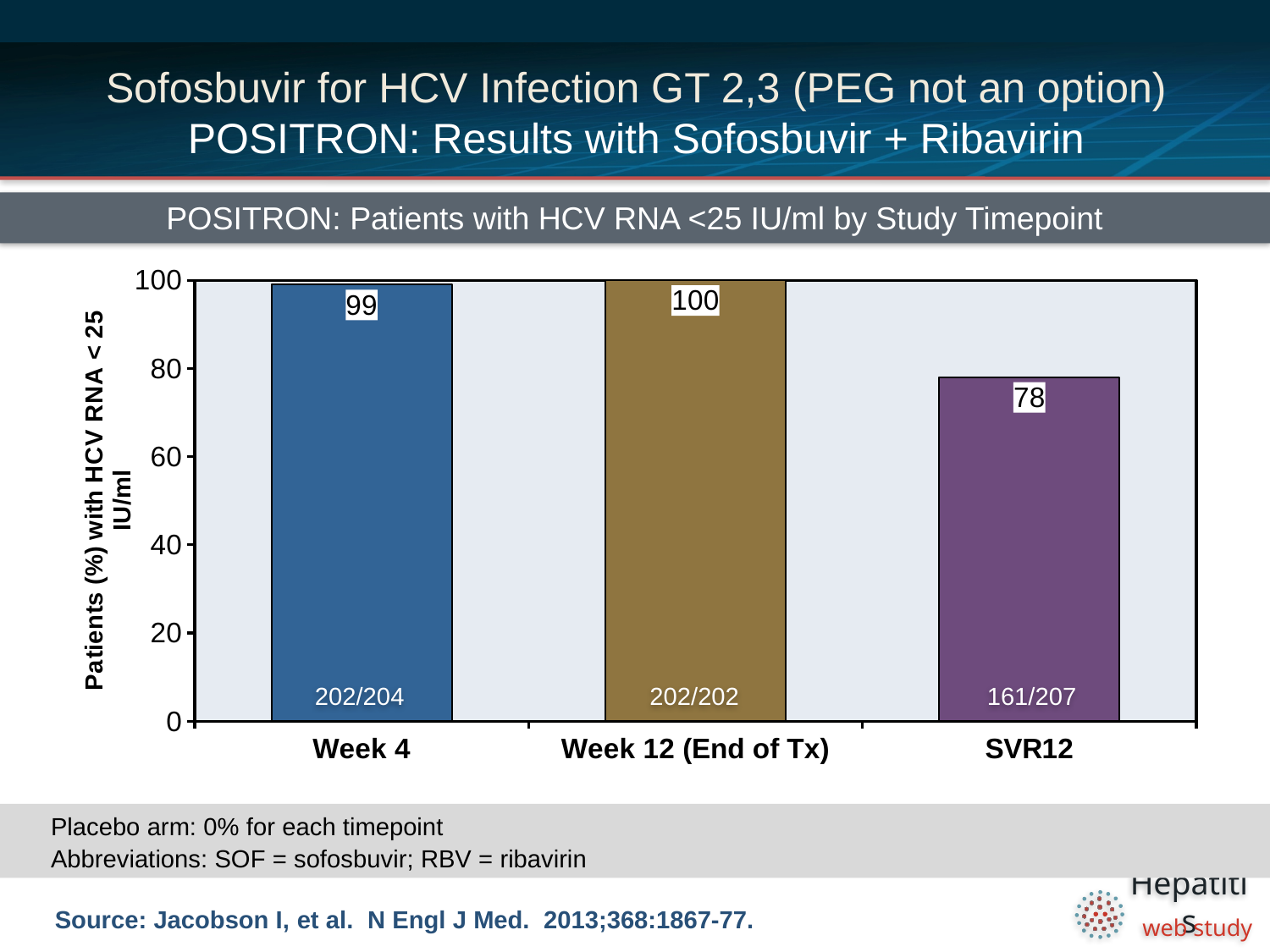
What kind of chart is shown on the slide? bar chart What is the difference between the values for Week 12 (End of Tx) and SVR12? 22 Is the value for SVR12 greater or less than 80? less What is the value for SVR12? 78 What is the difference between the values for Week 4 and SVR12? 21 What is the value for Week 12 (End of Tx)? 100 Which timepoint has the highest value? Week 12 (End of Tx) Which timepoint has the lowest value? SVR12 What is the patient fraction printed inside the SVR12 bar? 161/207 Which is larger, the value for Week 4 or the value for SVR12? Week 4 What is the value for Week 4? 99 How many timepoints are shown on the x axis? 3